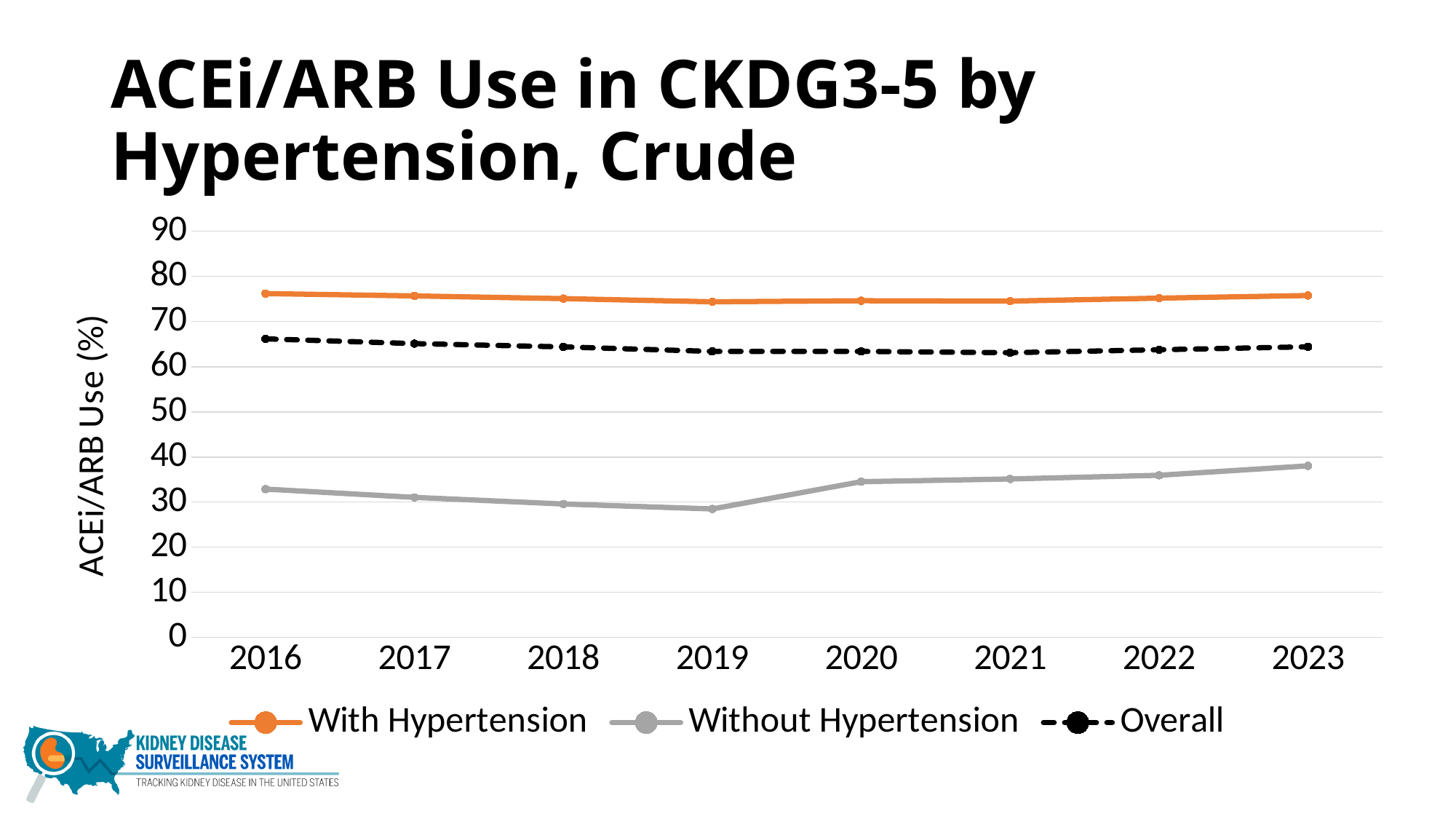
Is the value for Without Hypertension in 2019 greater or less than 30? less How many years are plotted along the x axis? 8 Does the Without Hypertension series rise or fall from 2019 to 2023? rise Is the value for With Hypertension in 2016 greater or less than 70? greater What kind of chart is shown on the slide? line chart Is the value for Overall in 2016 greater or less than 60? greater What is the label on the y axis? ACEi/ARB Use (%) For the Without Hypertension series, which year has the highest value? 2023 For the Without Hypertension series, which year has the lowest value? 2019 In 2020, which series has the larger value: With Hypertension or Without Hypertension? With Hypertension How many series does the legend list? 3